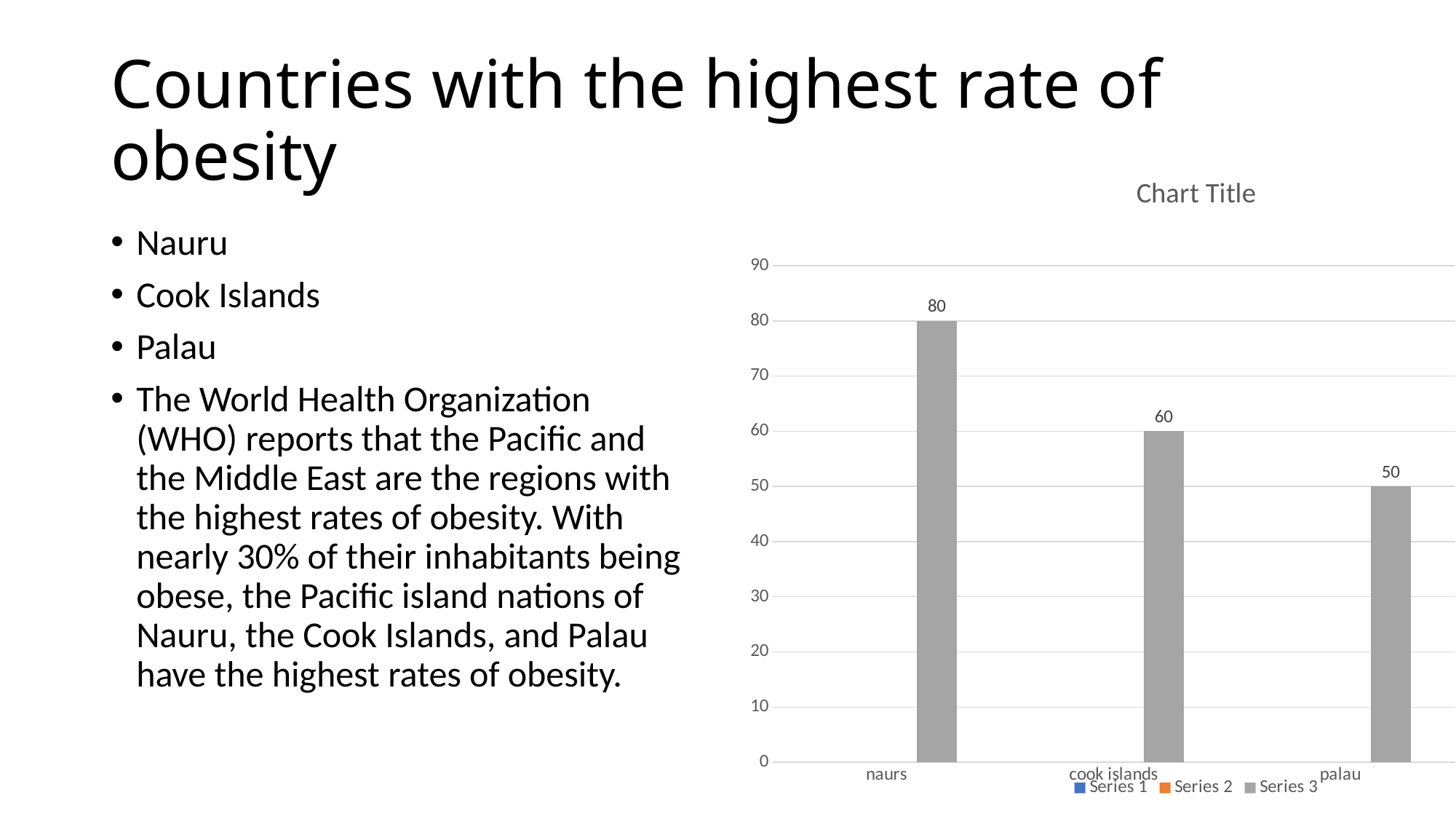
How many categories are shown on the x axis? 3 What is the value for palau? 50 What is the value for cook islands? 60 Which is larger, the value for cook islands or the value for palau? cook islands What is the value for naurs? 80 What is the difference between the values for naurs and palau? 30 What is the difference between the values for cook islands and palau? 10 What type of chart is shown on the slide? bar chart How many series does the legend list? 3 Which category has the highest value? naurs Which category has the lowest value? palau Do the values rise or fall from left to right along the x axis? fall